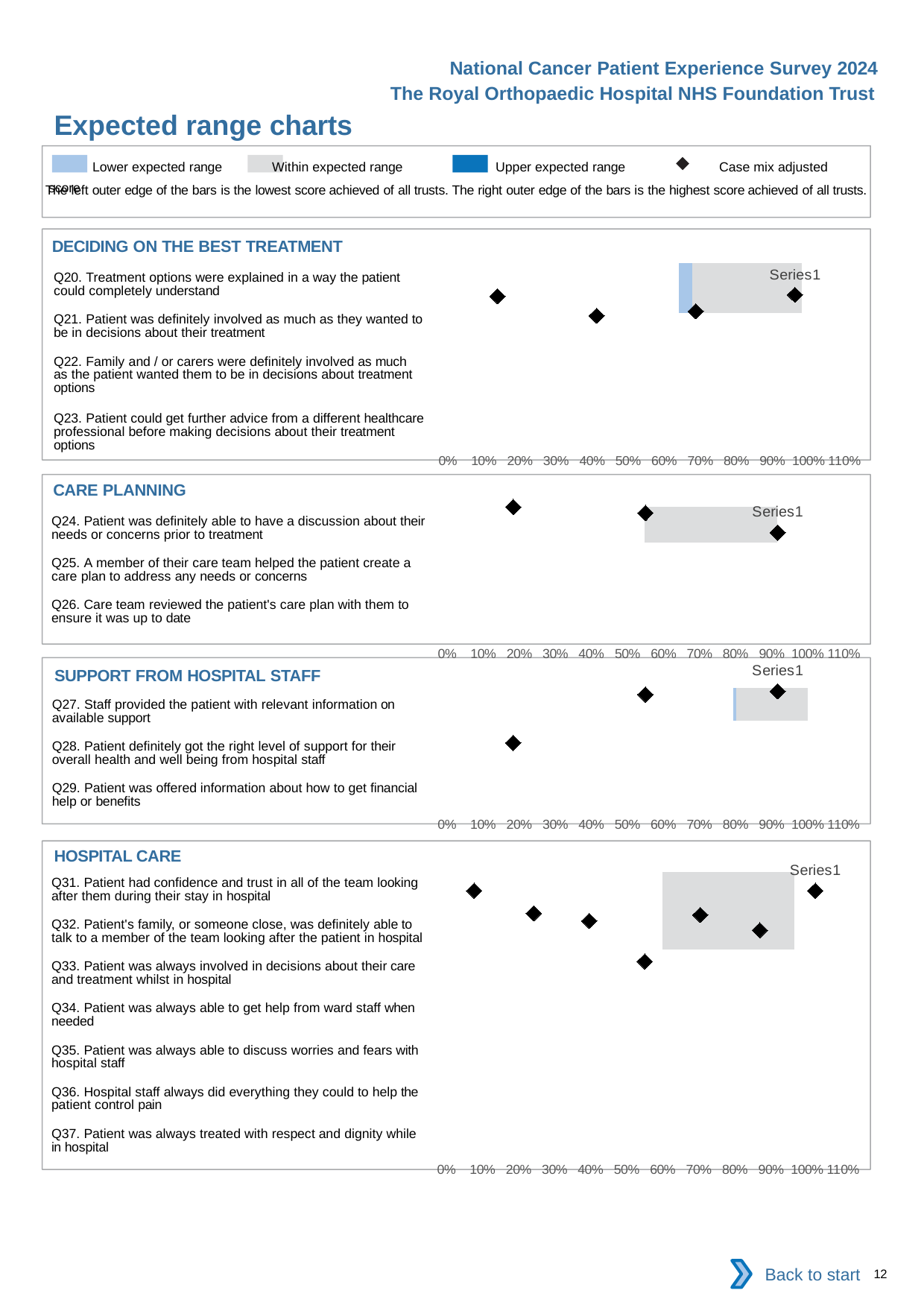
In the SUPPORT FROM HOSPITAL STAFF chart, how many diamond data points are plotted? 3 In the CARE PLANNING chart, how many diamond data points are plotted? 3 In the DECIDING ON THE BEST TREATMENT chart, is the rightmost plotted diamond greater or less than 80%? greater In the HOSPITAL CARE chart, is the leftmost plotted diamond greater or less than 20%? less What is the highest tick label shown on the x axis of the HOSPITAL CARE chart? 110% In the DECIDING ON THE BEST TREATMENT chart, how many diamond data points are plotted? 4 How many entries does the legend at the top of the slide list? 4 In the CARE PLANNING chart, is the leftmost plotted diamond greater or less than 30%? less What is the title of the first (top) chart on the slide? DECIDING ON THE BEST TREATMENT